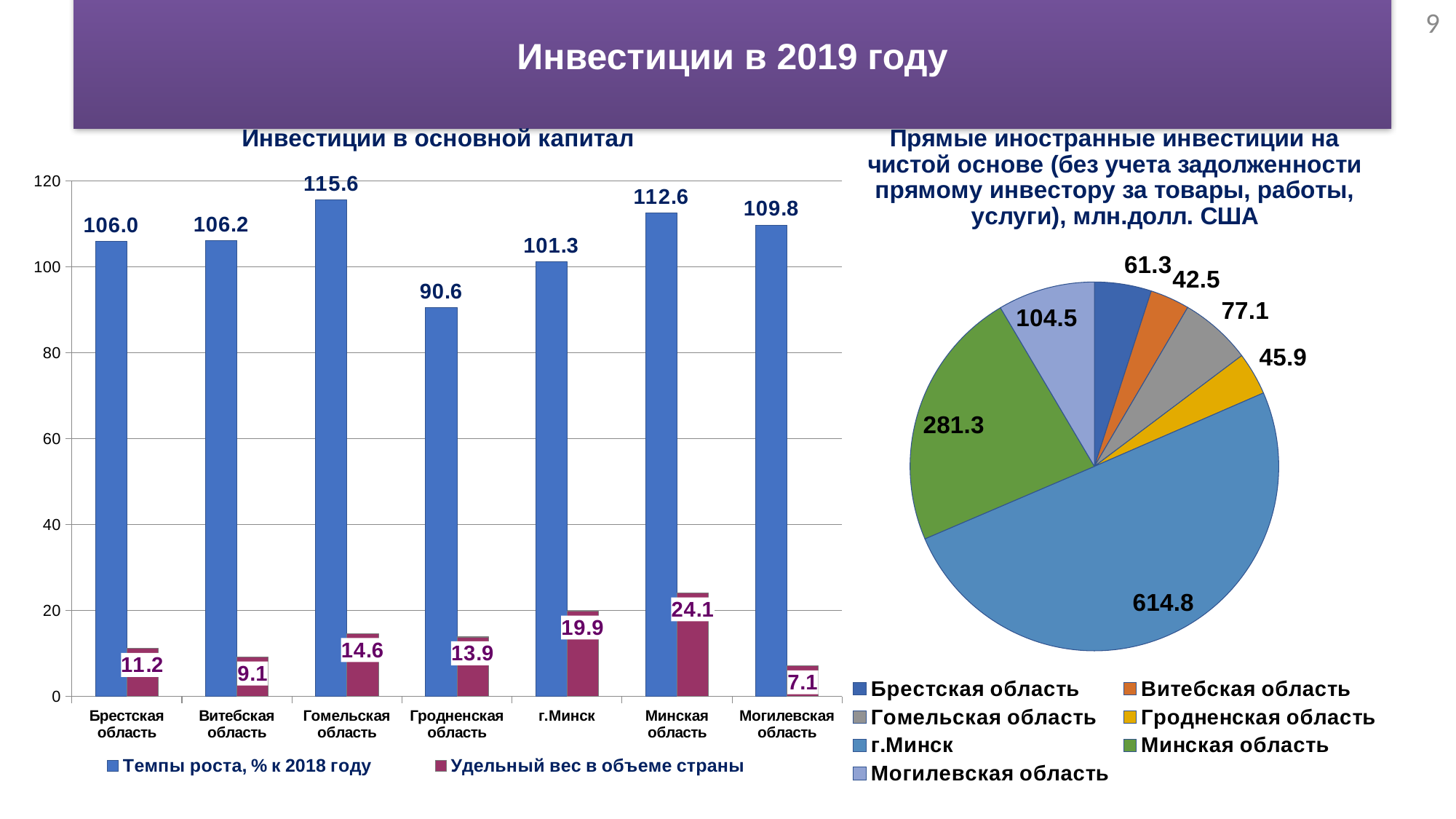
On the chart 'Инвестиции в основной капитал', is the 'Темпы роста' value for г.Минск greater or less than 100? greater On the chart 'Инвестиции в основной капитал', what is the value of 'Удельный вес в объеме страны' for Минская область? 24.1 On the pie chart on the right, what is the value for г.Минск? 614.8 On the chart 'Инвестиции в основной капитал', which region has the highest value of 'Удельный вес в объеме страны'? Минская область How many series does the legend of the chart 'Инвестиции в основной капитал' list? 2 On the pie chart on the right, which region has the smallest slice? Витебская область On the pie chart on the right, which is larger: the value for Минская область or the value for Могилевская область? Минская область On the chart 'Инвестиции в основной капитал', what is the difference between the 'Темпы роста' values for Гомельская область and Гродненская область? 25.0 What kind of chart is 'Инвестиции в основной капитал'? bar chart How many regions are shown on the x axis of the chart 'Инвестиции в основной капитал'? 7 On the chart 'Инвестиции в основной капитал', what is the value of 'Темпы роста, % к 2018 году' for Гомельская область? 115.6 On the chart 'Инвестиции в основной капитал', which region has the lowest value of 'Темпы роста, % к 2018 году'? Гродненская область